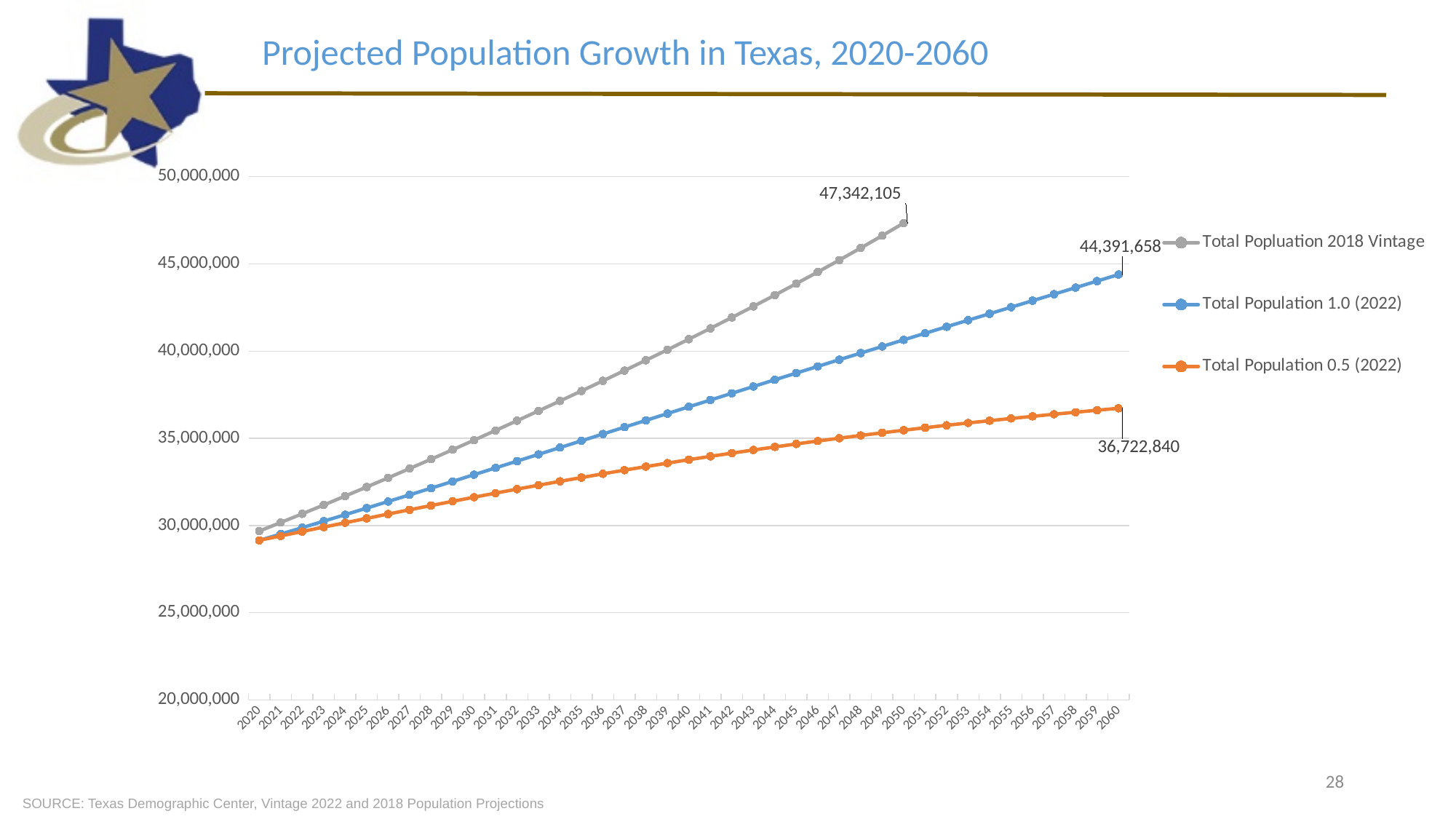
In 2060, which is larger: Total Population 1.0 (2022) or Total Population 0.5 (2022)? Total Population 1.0 (2022) Which series reaches the highest labelled value on the chart? Total Popluation 2018 Vintage Is the value for Total Popluation 2018 Vintage in 2045 greater or less than 40,000,000? greater What is the labelled value of the Total Population 1.0 (2022) series in 2060? 44,391,658 What is the difference between the 2060 values of the Total Population 1.0 (2022) and Total Population 0.5 (2022) series? 7,668,818 What kind of chart is shown on the slide? Line chart How many series does the legend list? 3 Is the value for Total Population 0.5 (2022) in 2040 greater or less than 35,000,000? less Do the values of the Total Population 0.5 (2022) series rise or fall from 2020 to 2060? Rise What is the labelled value of the Total Popluation 2018 Vintage series at its final point in 2050? 47,342,105 In which year does the Total Popluation 2018 Vintage series end? 2050 What is the labelled value of the Total Population 0.5 (2022) series in 2060? 36,722,840